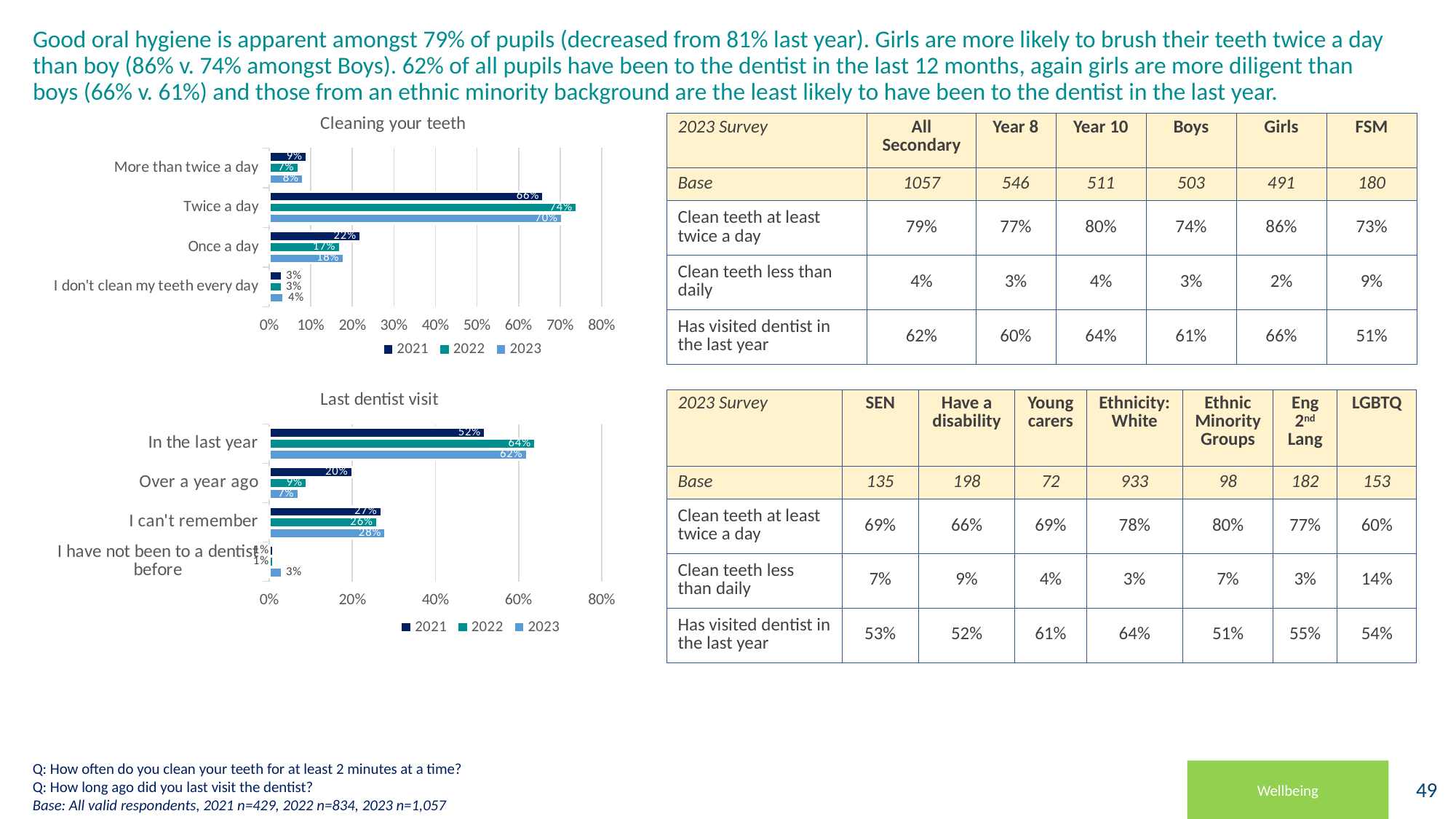
In the 'Cleaning your teeth' chart, how many series does the legend list? 3 In the 'Last dentist visit' chart, what is the 2022 value for 'In the last year'? 64% In the 'Last dentist visit' chart, what is the difference between the 2023 and 2021 values for 'In the last year'? 10% What kind of chart is the 'Last dentist visit' chart? Bar chart In the 'Last dentist visit' chart, is the 2021 value for 'Over a year ago' larger or smaller than the 2023 value? larger In the 'Last dentist visit' chart, which category has the lowest 2023 value? I have not been to a dentist before In the 'Cleaning your teeth' chart, what is the 2022 value for 'Once a day'? 17% In the 'Cleaning your teeth' chart, what is the difference between the 2022 and 2021 values for 'Twice a day'? 8% In the 'Cleaning your teeth' chart, which category has the highest 2022 value? Twice a day In the 'Last dentist visit' chart, what is the 2023 value for 'Over a year ago'? 7% In the 'Cleaning your teeth' chart, what is the 2023 value for 'Twice a day'? 70% In the 'Last dentist visit' chart, how many categories are shown? 4